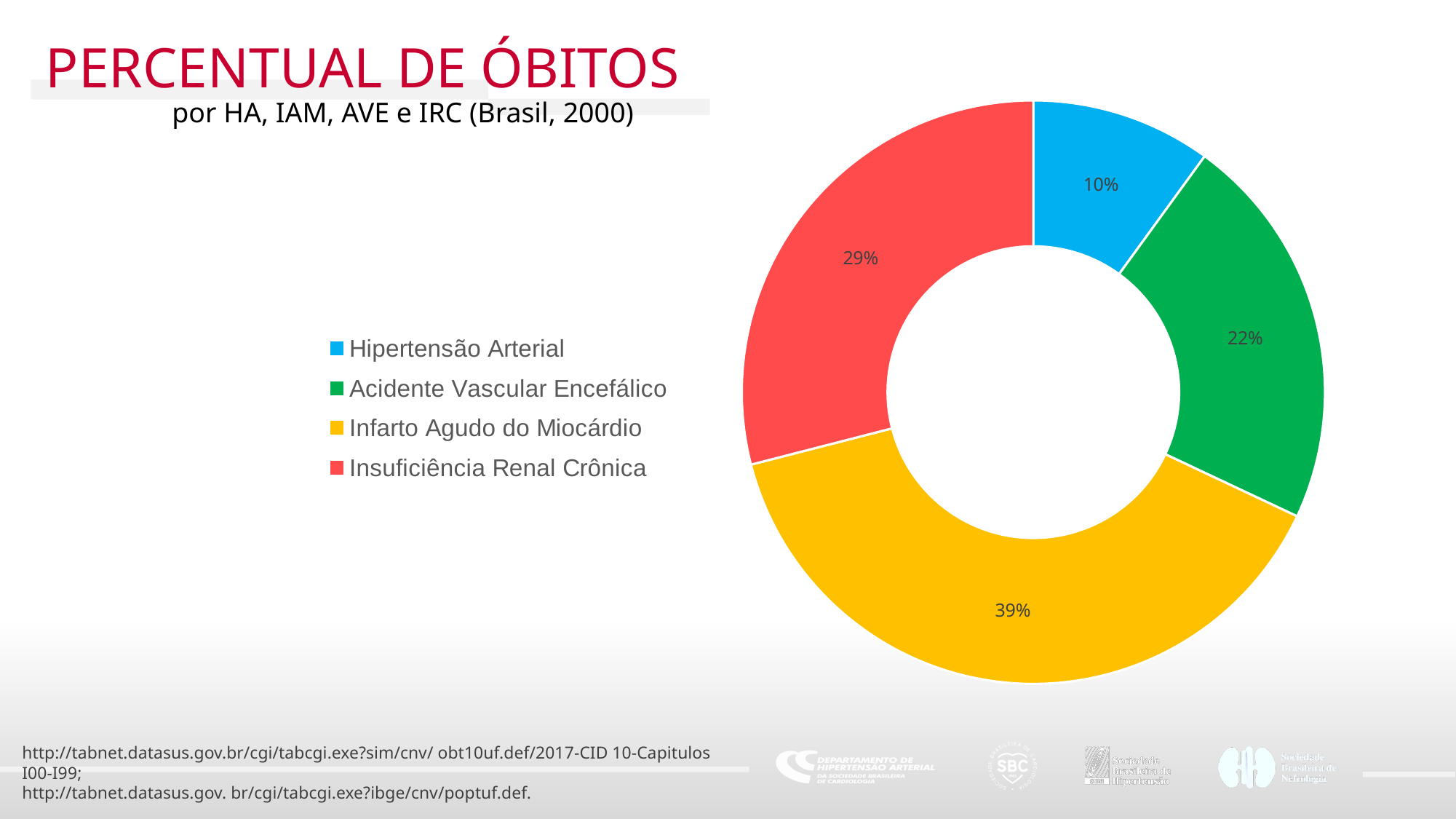
Which has a larger share of deaths, Acidente Vascular Encefálico or Insuficiência Renal Crônica? Insuficiência Renal Crônica What kind of chart is shown on the slide? Doughnut (pie) chart What percentage of deaths is attributed to Acidente Vascular Encefálico? 22% What is the difference in percentage points between Infarto Agudo do Miocárdio and Insuficiência Renal Crônica? 10 What is the combined share of Hipertensão Arterial and Acidente Vascular Encefálico? 32% What percentage of deaths is attributed to Infarto Agudo do Miocárdio? 39% What percentage of deaths is attributed to Insuficiência Renal Crônica? 29% What colour represents Acidente Vascular Encefálico in the chart? Green Which cause accounts for the smallest share of deaths? Hipertensão Arterial What percentage of deaths is attributed to Hipertensão Arterial? 10% How many categories are shown in the chart? 4 Which cause accounts for the largest share of deaths? Infarto Agudo do Miocárdio